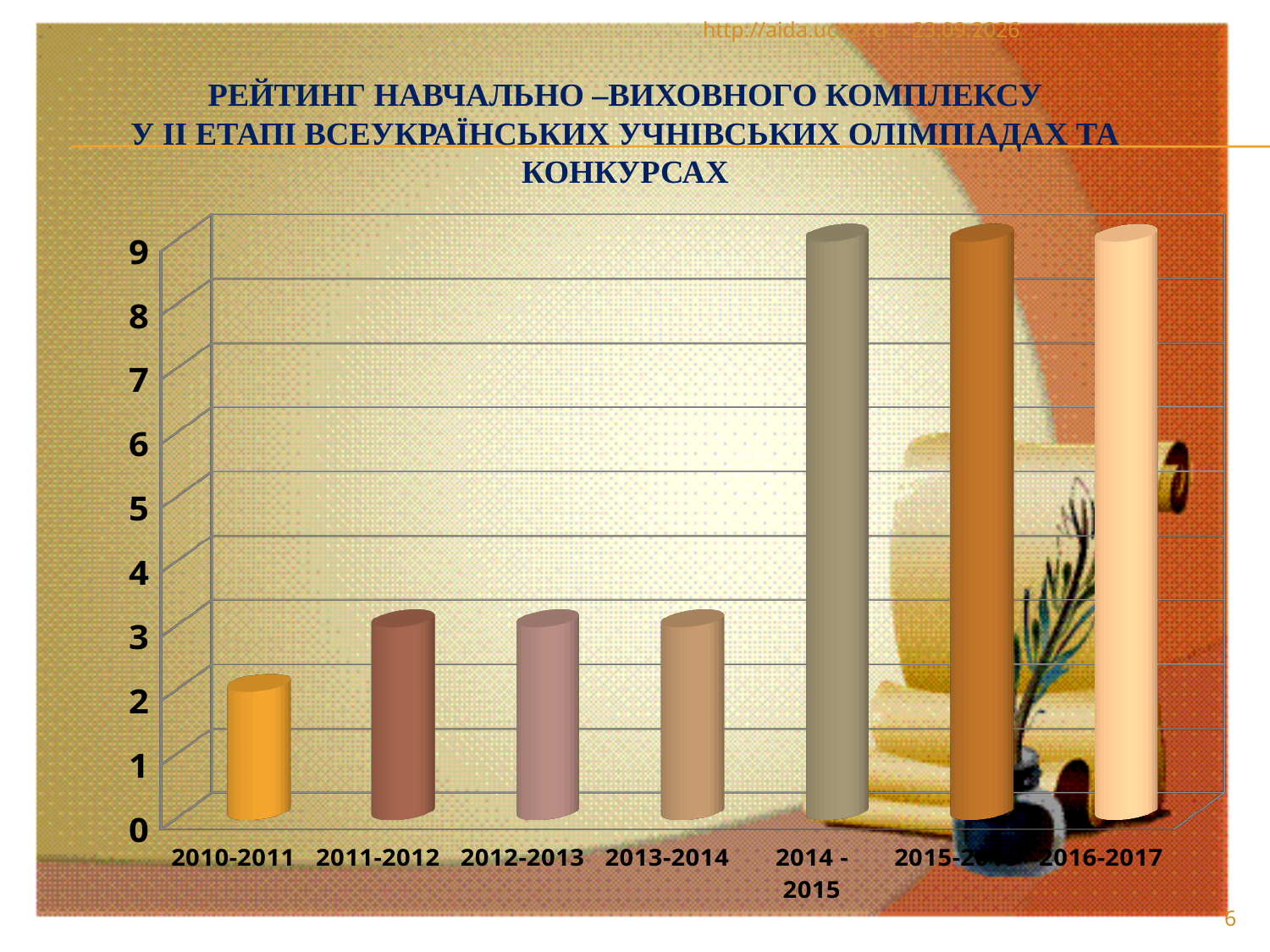
What is the first line of the chart's title? РЕЙТИНГ НАВЧАЛЬНО –ВИХОВНОГО КОМПЛЕКСУ Do the values generally rise or fall from 2010-2011 to 2016-2017? rise Is the value for 2014 - 2015 greater or less than 5? greater Is the value for 2011-2012 greater or less than 5? less How many school-year categories are shown on the x axis? 7 Is the value for 2010-2011 greater or less than 3? less Which is larger, the value for 2013-2014 or the value for 2014 - 2015? 2014 - 2015 Which is larger, the value for 2010-2011 or the value for 2012-2013? 2012-2013 What kind of chart is shown on the slide? bar chart Which school year has the lowest value? 2010-2011